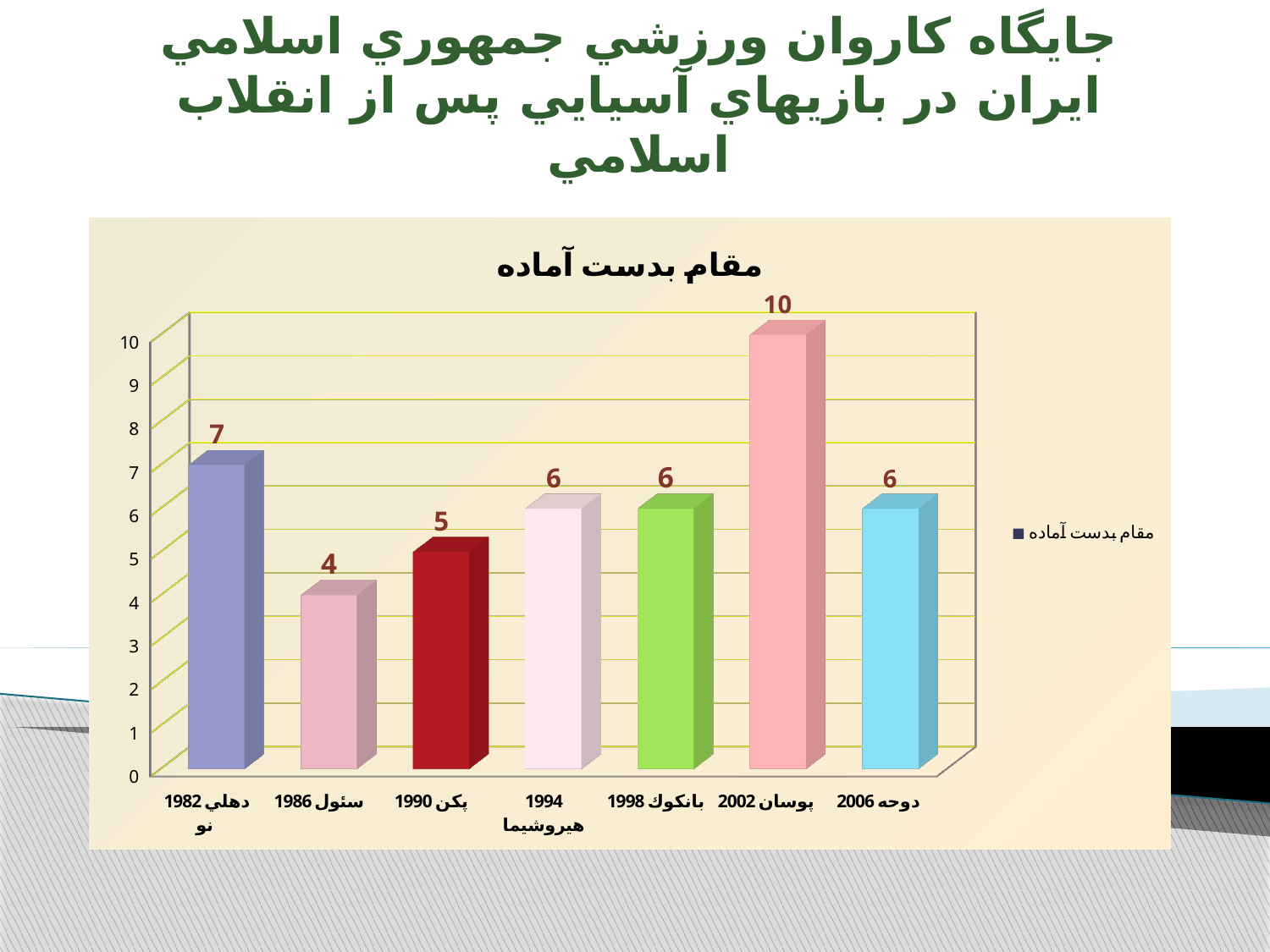
What is the value for 2006 (Doha / دوحه)? 6 What kind of chart is this? bar chart What is the title of the chart? مقام بدست آماده How many series does the legend list? 1 What is the value for 1990 (Beijing / پكن)? 5 Which category has the lowest value? 1986 سئول (Seoul) How many categories are shown on the x axis? 7 Which is larger, the value for 1982 (New Delhi) or the value for 1990 (Beijing)? 1982 دهلي نو (New Delhi) What is the value for 2002 (Busan / پوسان)? 10 What is the difference between the values for 2002 (Busan) and 1986 (Seoul)? 6 What is the value for 1982 (New Delhi / دهلي نو)? 7 Which category has the highest value? 2002 پوسان (Busan)